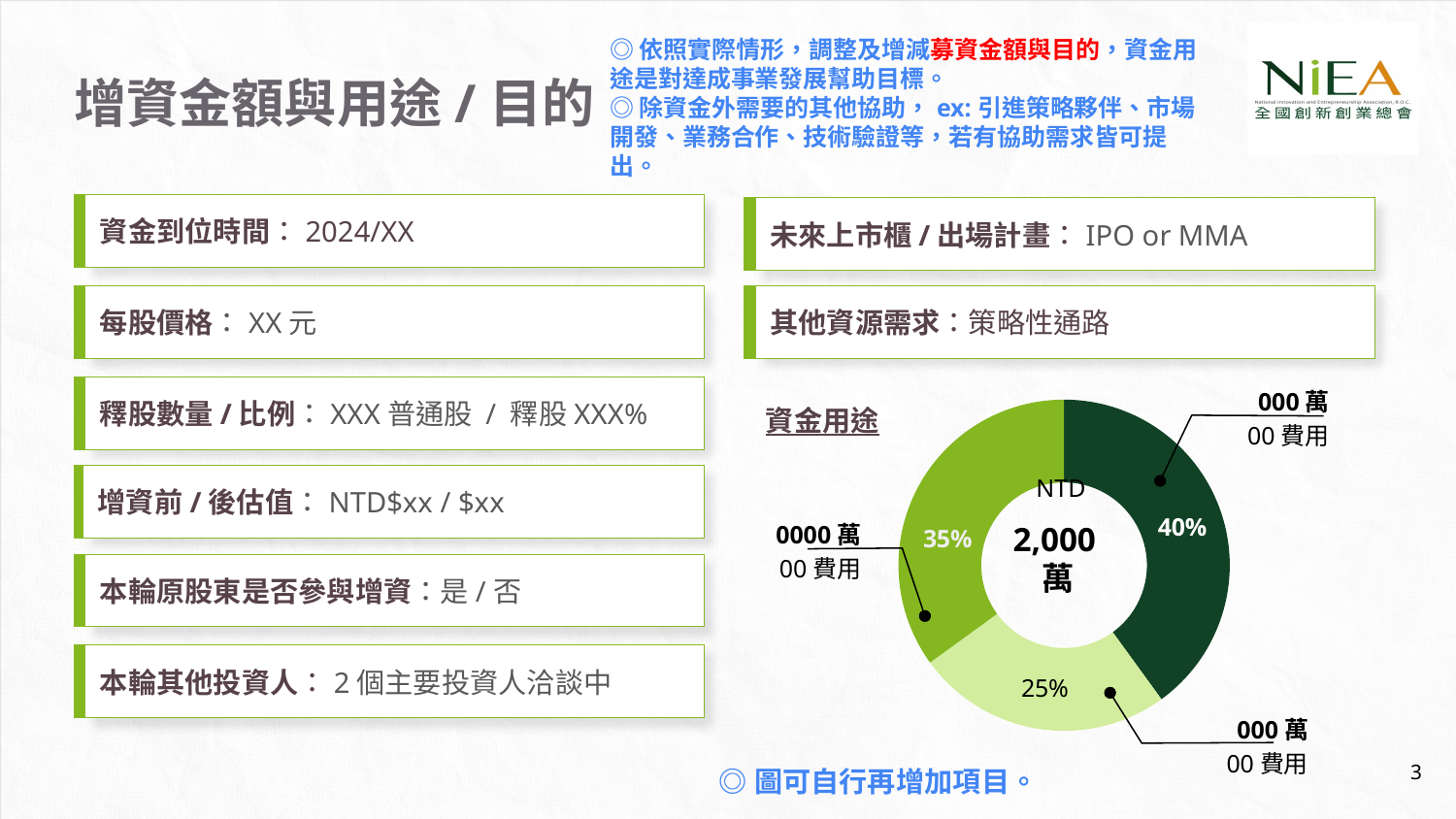
What is the difference between the largest and smallest slices in the 資金用途 chart? 15% What is the largest share shown in the 資金用途 chart? 40% How many slices does the 資金用途 donut chart have? 3 What total amount is shown in the centre of the 資金用途 donut chart? NTD 2,000 萬 What is the smallest share shown in the 資金用途 chart? 25% Which slice is larger in the 資金用途 chart, the 35% slice or the 25% slice? 35% What percentage is shown on the medium green slice on the left of the 資金用途 chart? 35% What is the title of the donut chart on the slide? 資金用途 What do the three slice percentages in the 資金用途 chart add up to? 100% What percentage is shown on the light green slice at the bottom of the 資金用途 chart? 25% What kind of chart is the 資金用途 chart? pie chart (donut) What percentage is shown on the dark green slice of the 資金用途 chart? 40%